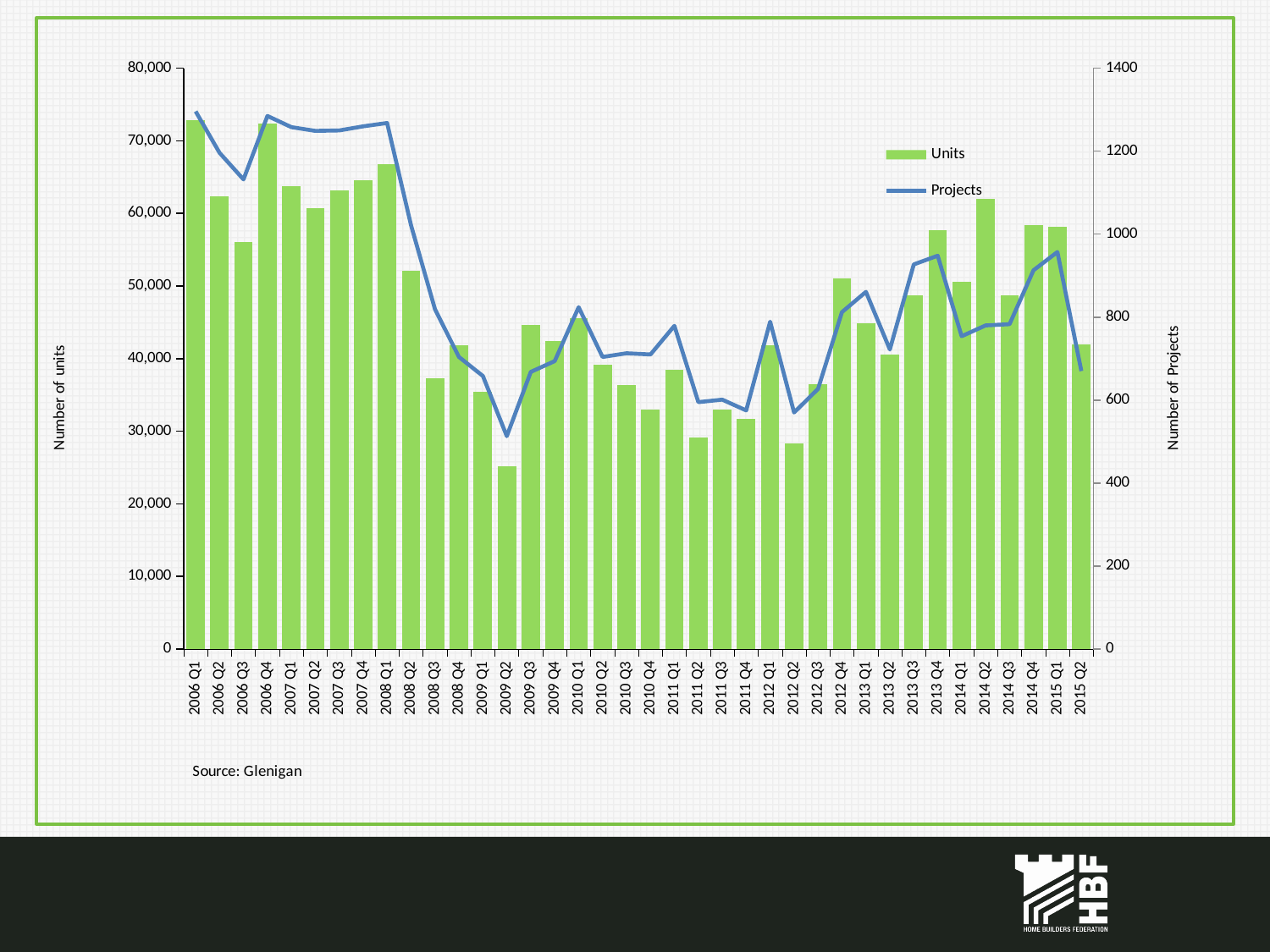
Which quarter has the lowest value for Units? 2009 Q2 How many series does the legend list? 2 Is the Units value for 2014 Q2 greater or less than 60,000? greater What are the two series named in the legend? Units and Projects How many quarters are shown along the x axis? 38 What kind of chart is shown on the slide? Combined bar and line chart Is the Units value for 2009 Q2 greater or less than 30,000? less Is the Projects value for 2015 Q2 greater or less than 700? less Which has the larger Units value, 2012 Q1 or 2012 Q2? 2012 Q1 Do the Units values rise or fall from 2008 Q1 to 2009 Q2? fall Which quarter has the lowest value for Projects? 2009 Q2